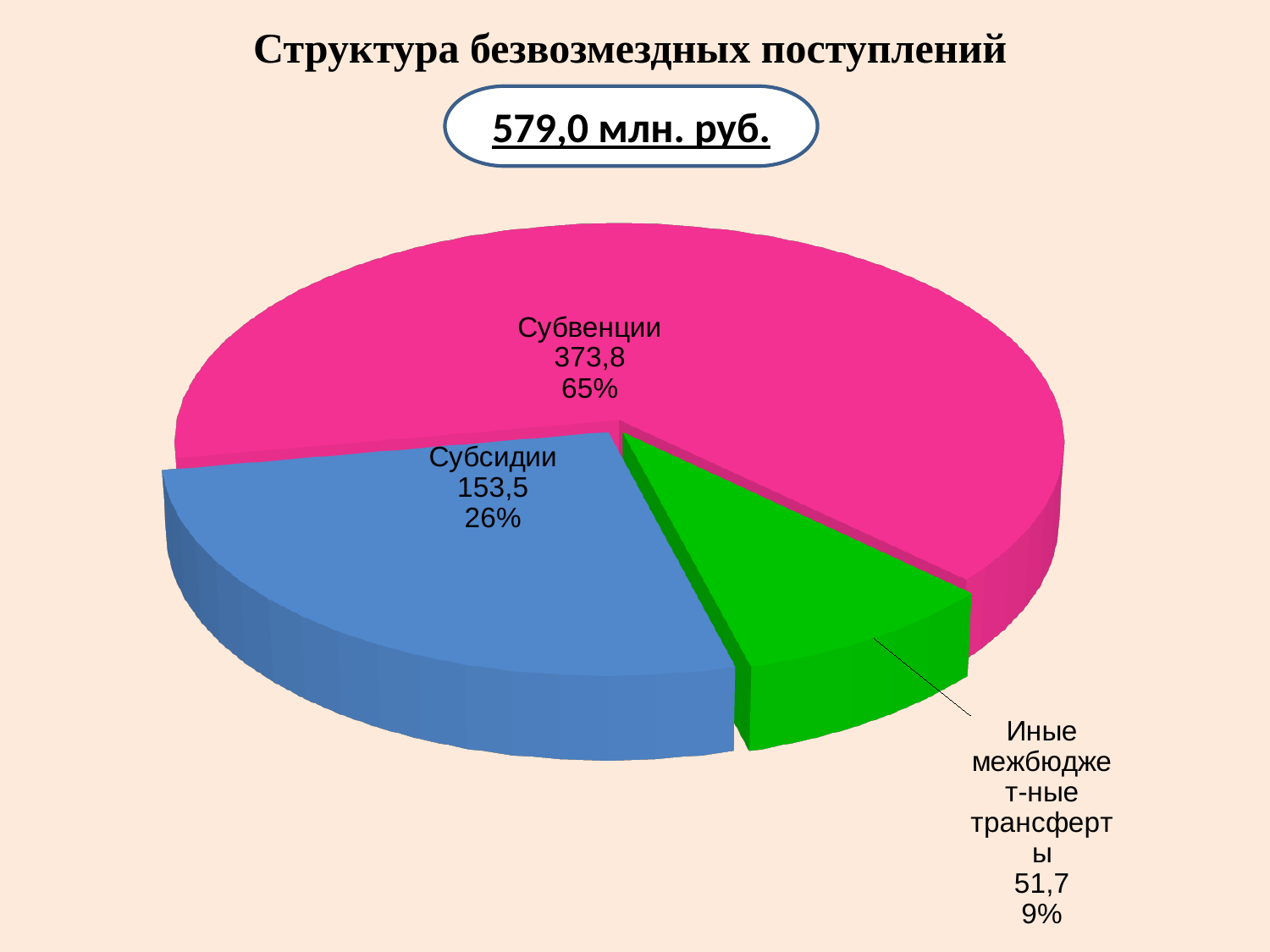
Which category has the largest slice? Субвенции What is the value for Субсидии? 153,5 How many slices does the pie chart have? 3 What is the value for Иные межбюджетные трансферты? 51,7 What share of the pie does Иные межбюджетные трансферты represent? 9% What type of chart is shown on the slide? Pie chart What is the difference between the values for Субвенции and Субсидии? 220,3 Which is larger, the value for Субсидии or the value for Иные межбюджетные трансферты? Субсидии What is the value for Субвенции? 373,8 What share of the pie does Субсидии represent? 26% Which category has the smallest slice? Иные межбюджетные трансферты What share of the pie does Субвенции represent? 65%